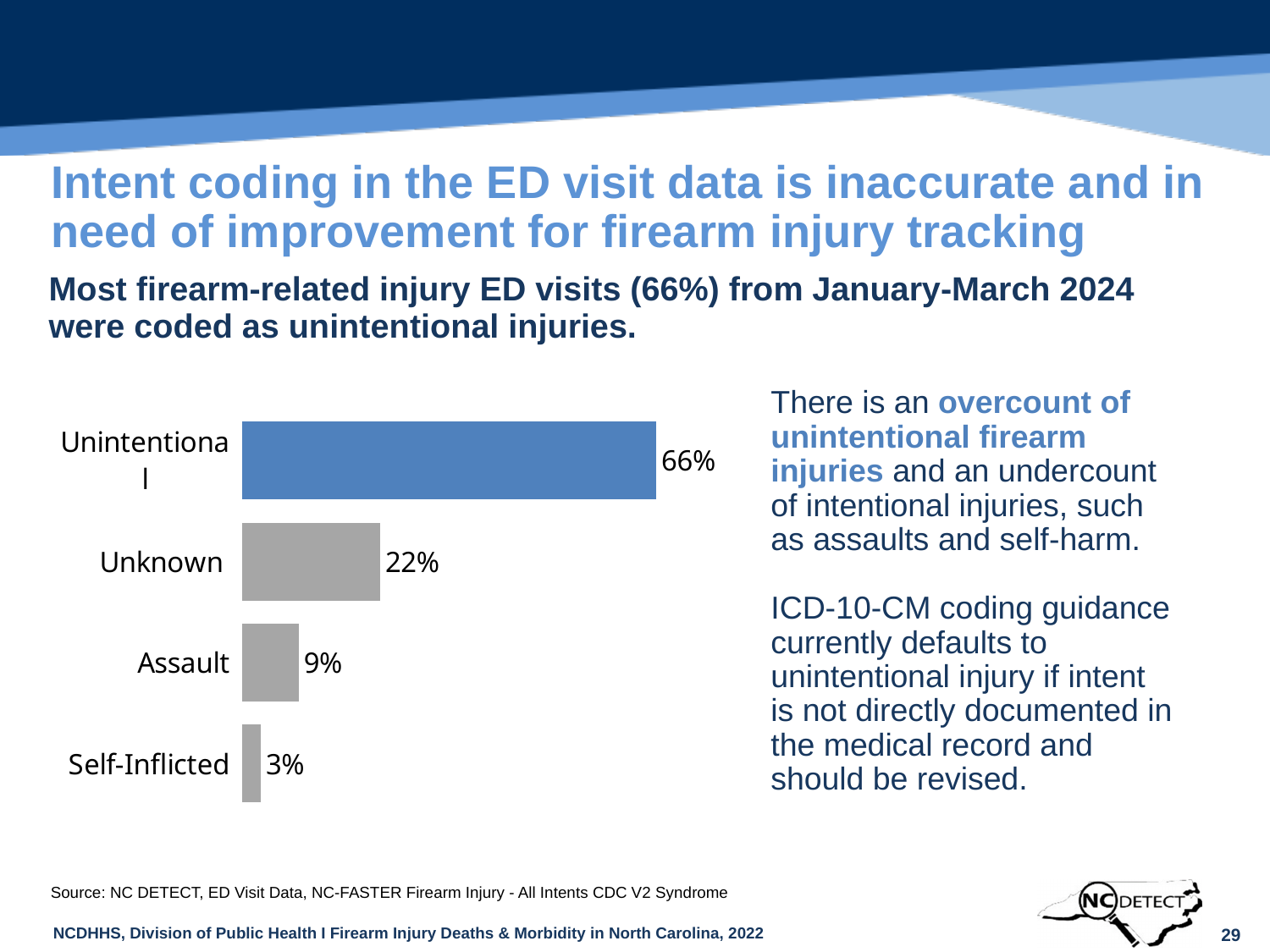
Which is larger, the value for Unknown or the value for Assault? Unknown What is the difference in percentage points between Assault and Self-Inflicted? 6 What is the difference in percentage points between Unintentional and Unknown? 44 What percentage of firearm-related injury ED visits were coded as Unintentional? 66% How many categories are shown in the chart? 4 What is the value shown for the Unknown category? 22% What is the value for Self-Inflicted? 3% What kind of chart is shown on the slide? Bar chart What percentage is shown for Assault? 9% Which category has the lowest percentage? Self-Inflicted Which bar in the chart is coloured blue rather than grey? Unintentional Which category has the highest percentage? Unintentional